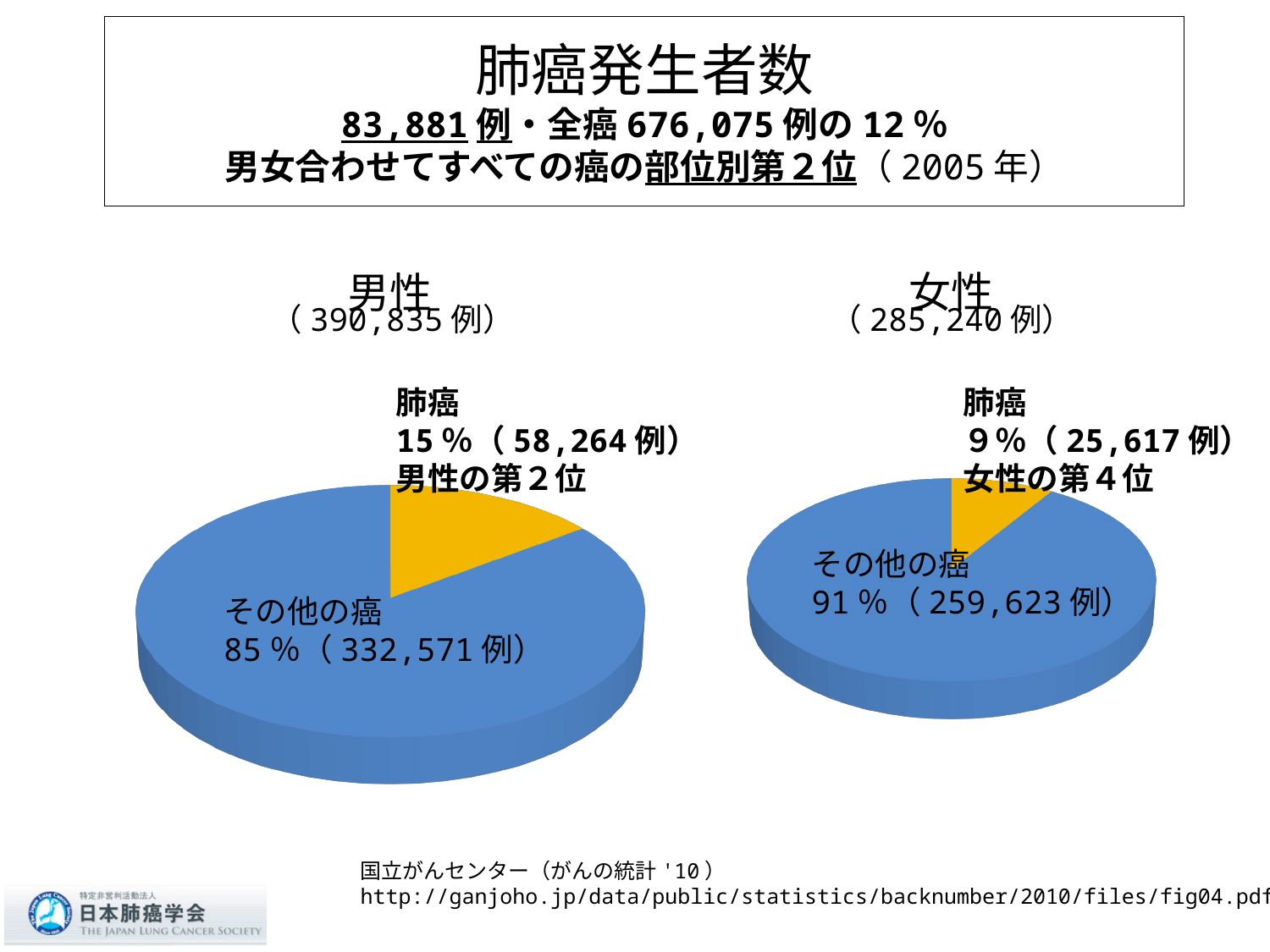
In the 男性 (male) pie chart, how many cases (例) are shown for 肺癌? 58,264例 In the 女性 (female) pie chart, how many cases (例) are shown for その他の癌? 259,623例 Which is larger: the 肺癌 share in the 男性 (male) pie chart or in the 女性 (female) pie chart? 男性 (male) How many slices does the 女性 (female) pie chart have? 2 In the 女性 (female) pie chart, how many cases (例) are shown for 肺癌? 25,617例 In the 女性 (female) pie chart, which slice is the smallest? 肺癌 In the 女性 (female) pie chart, what percentage is 肺癌? 9% In the 男性 (male) pie chart, what percentage is 肺癌? 15% In the 男性 (male) pie chart, which slice is the largest? その他の癌 What kind of chart is used for the 男性 (male) data on the slide? Pie chart What is the difference in percentage points between the 肺癌 share in the 男性 (male) pie chart and the 女性 (female) pie chart? 6 percentage points In the 男性 (male) pie chart, what percentage is その他の癌? 85%